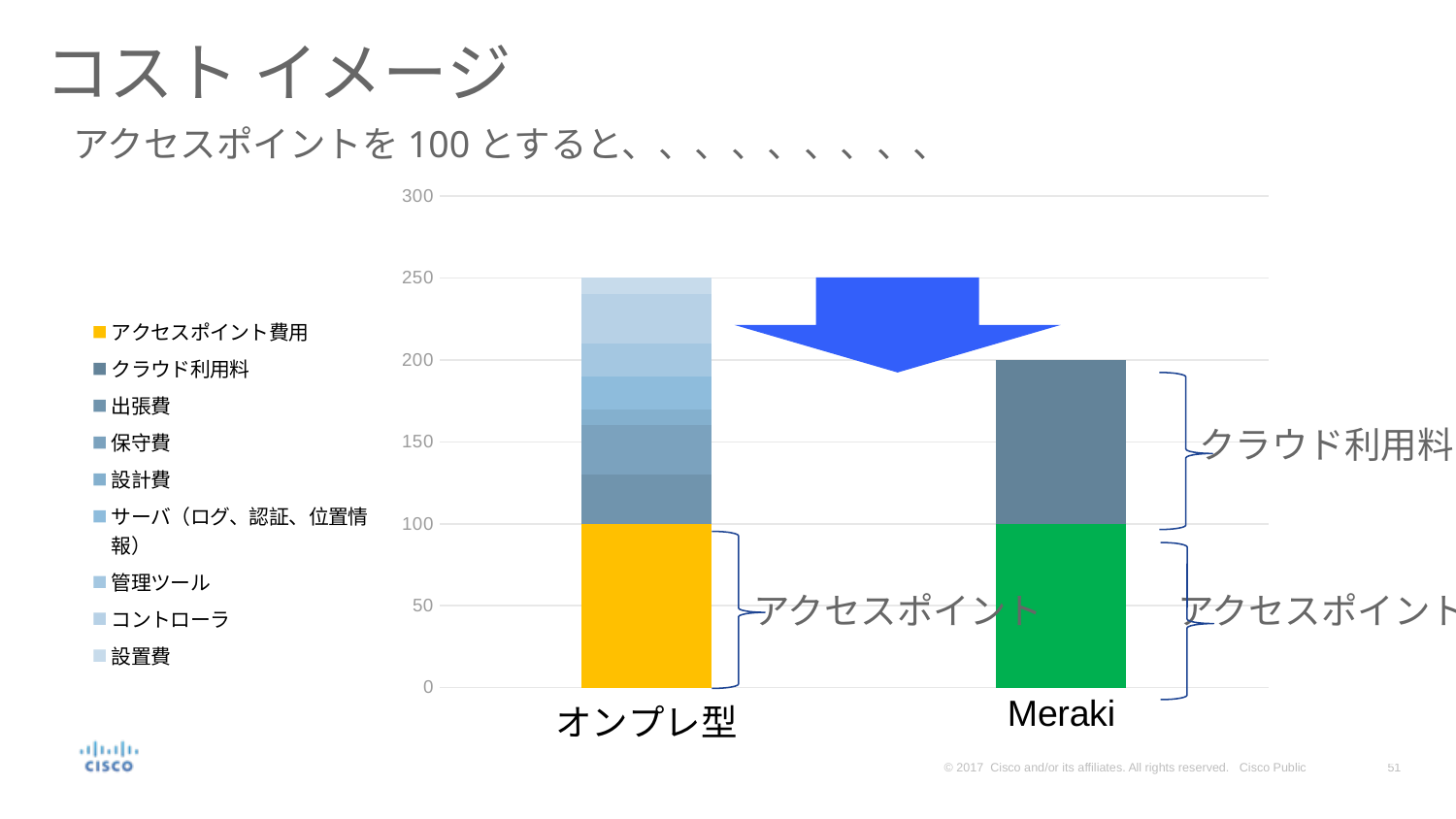
Which category has the lowest total bar? Meraki What is the value of the アクセスポイント費用 segment in the オンプレ型 bar? 100 What is the title of the slide containing the chart? コスト イメージ What is the difference between the total of the オンプレ型 bar and the total of the Meraki bar? 50 Which category has the higher total bar, オンプレ型 or Meraki? オンプレ型 What kind of chart is shown on the slide? stacked bar chart What is the value of the クラウド利用料 segment in the Meraki bar? 100 How many categories are shown on the x axis of the chart? 2 Is the total of the オンプレ型 bar greater or less than 200? greater What is the total height of the オンプレ型 stacked bar? 250 What is the total height of the Meraki stacked bar? 200 How many series does the chart legend list? 9